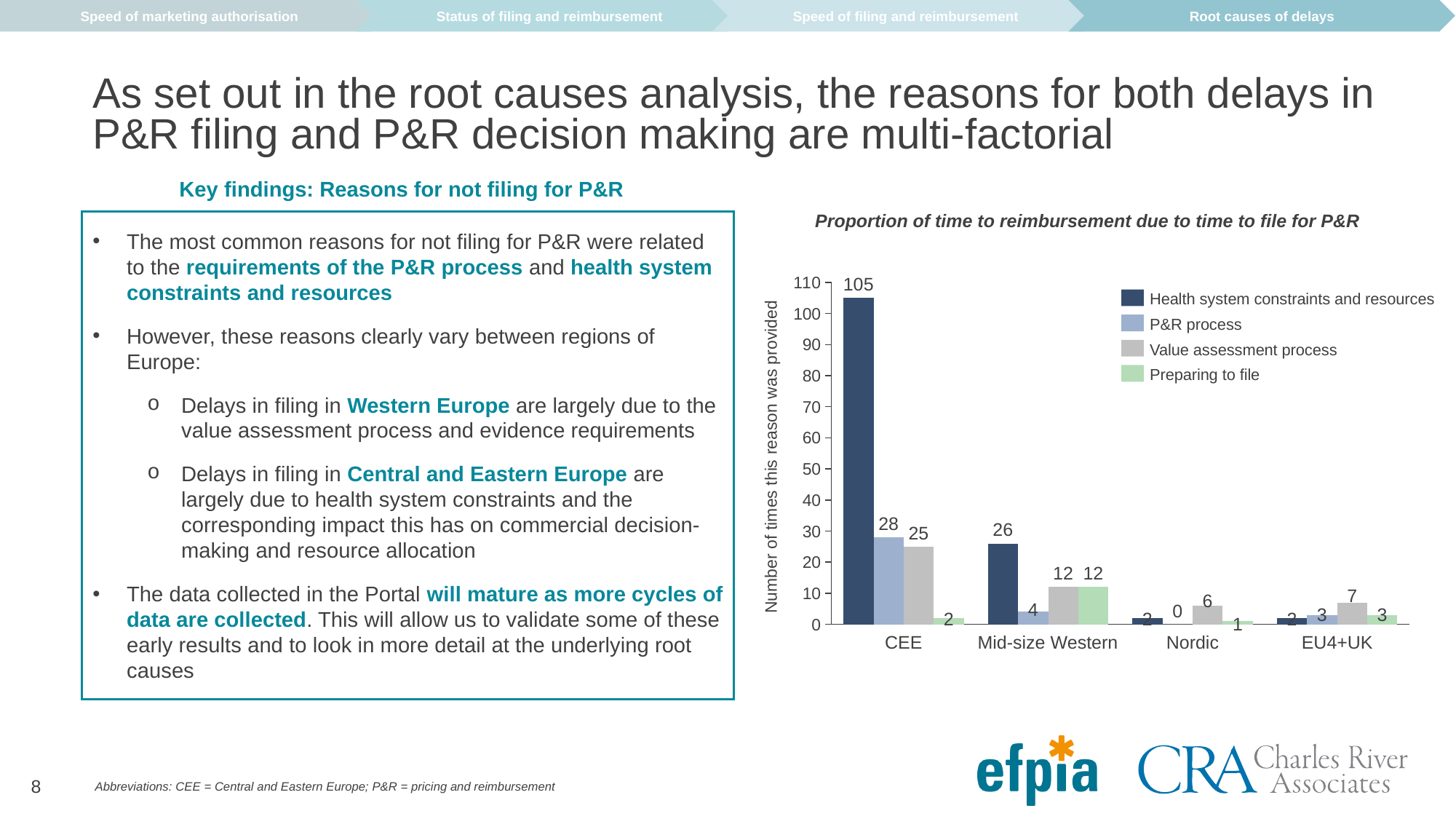
What is the y-axis label of the chart? Number of times this reason was provided What is the value for Value assessment process in Nordic? 6 Which is larger in CEE: P&R process or Value assessment process? P&R process How many series does the legend list? 4 How many region categories are shown on the x axis? 4 What is the value for Value assessment process in Mid-size Western? 12 What type of chart is shown on the slide? bar chart What is the value for P&R process in CEE? 28 What is the value for Health system constraints and resources in CEE? 105 What is the difference between the Health system constraints and resources value for CEE and for Mid-size Western? 79 Which region has the highest value for Health system constraints and resources? CEE What is the value for P&R process in Nordic? 0